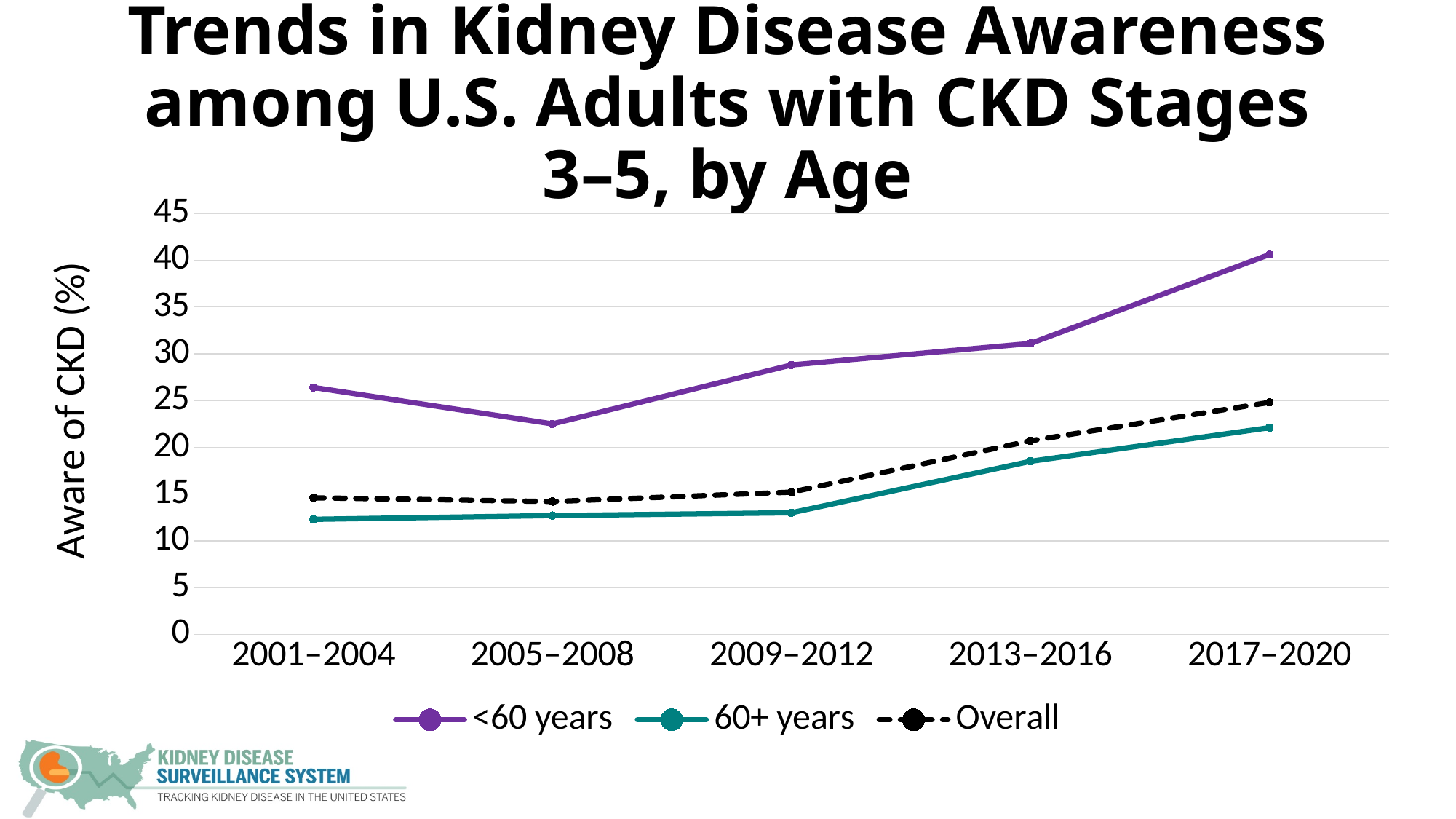
What is the label on the y axis? Aware of CKD (%) What kind of chart is shown on the slide? line chart Is the value for <60 years in 2005–2008 greater or less than 25? less In which period is the value for <60 years highest? 2017–2020 How many time periods are shown on the x axis? 5 Is the value for Overall in 2017–2020 greater or less than 20? greater Is the value for <60 years in 2017–2020 greater or less than 35? greater Which is larger in 2017–2020, the value for <60 years or for 60+ years? <60 years In which period is the value for <60 years lowest? 2005–2008 Does the value for 60+ years rise or fall from 2009–2012 to 2017–2020? rise How many series does the legend list? 3